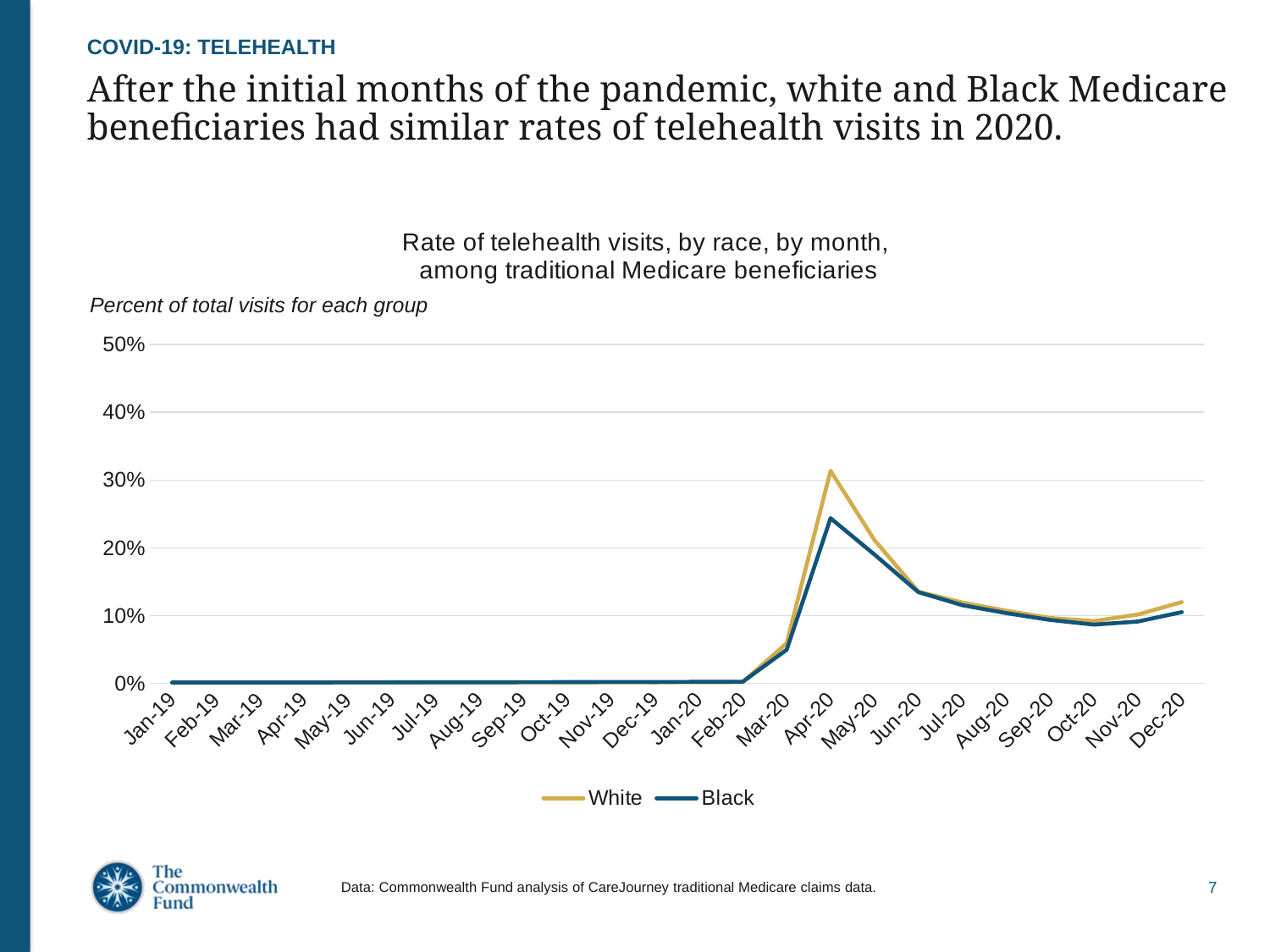
In which month does the Black series reach its highest value? Apr-20 What kind of chart is shown on the slide? line chart How many months are plotted along the x axis? 24 In Apr-20, which series has the larger value, White or Black? White What are the two series named in the legend? White and Black Is the value for Black in Apr-20 greater or less than 20%? greater How many series does the legend list? 2 In which month does the White series reach its highest value? Apr-20 Is the value for White in Jan-19 greater or less than 10%? less Is the value for White in Jun-20 greater or less than 10%? greater Do the values for the Black series rise or fall from Apr-20 to Oct-20? fall